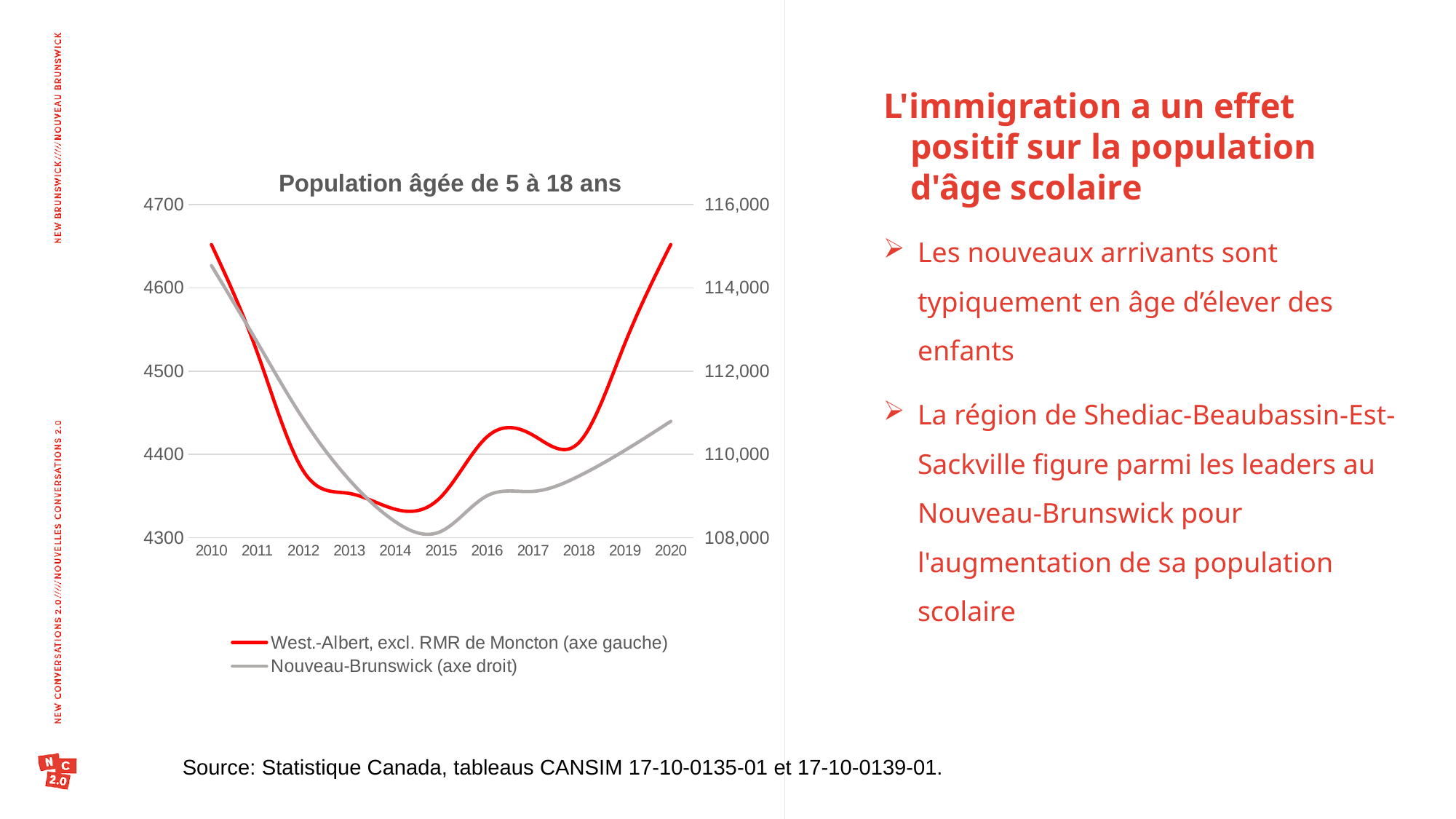
In which year is the Nouveau-Brunswick series at its highest? 2010 What kind of chart is shown on the slide? line chart Does the Nouveau-Brunswick series rise or fall from 2010 to 2015? fall Which series is plotted on the right axis (axe droit)? Nouveau-Brunswick Is the value for Nouveau-Brunswick in 2010 greater or less than 114,000? greater Is the value for Nouveau-Brunswick in 2020 greater or less than 112,000? less How many years are plotted along the x axis of the chart? 11 Is the value for West.-Albert, excl. RMR de Moncton in 2010 greater or less than 4600? greater For West.-Albert, excl. RMR de Moncton, which year has the larger value, 2014 or 2020? 2020 How many series does the chart's legend list? 2 What is the title of the chart? Population âgée de 5 à 18 ans